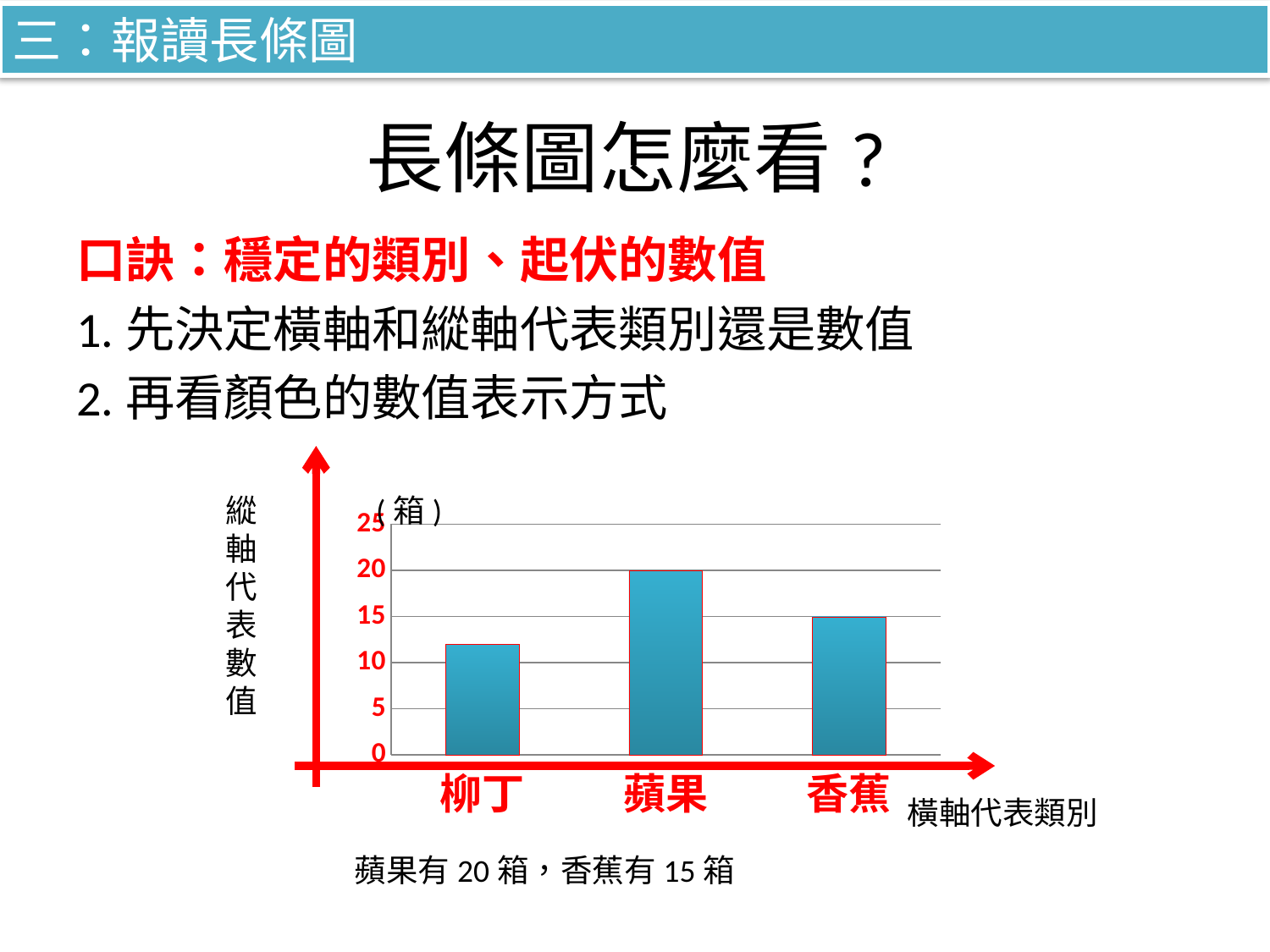
Which category has the highest bar in the chart? 蘋果 What is the highest tick value shown on the vertical axis of the chart? 25 What unit is shown at the top of the vertical axis of the chart? 箱 How many 箱 does 香蕉 have according to the chart? 15 箱 How many 箱 does 蘋果 have according to the chart? 20 箱 Which category has the lowest bar in the chart? 柳丁 Is the value for 柳丁 greater or less than 15? less Which has the larger value, 柳丁 or 香蕉? 香蕉 What is the difference between the values for 蘋果 and 香蕉? 5 箱 What kind of chart is shown on the slide? bar chart How many categories are plotted on the x axis of the chart? 3 Is the value for 柳丁 greater or less than 10? greater